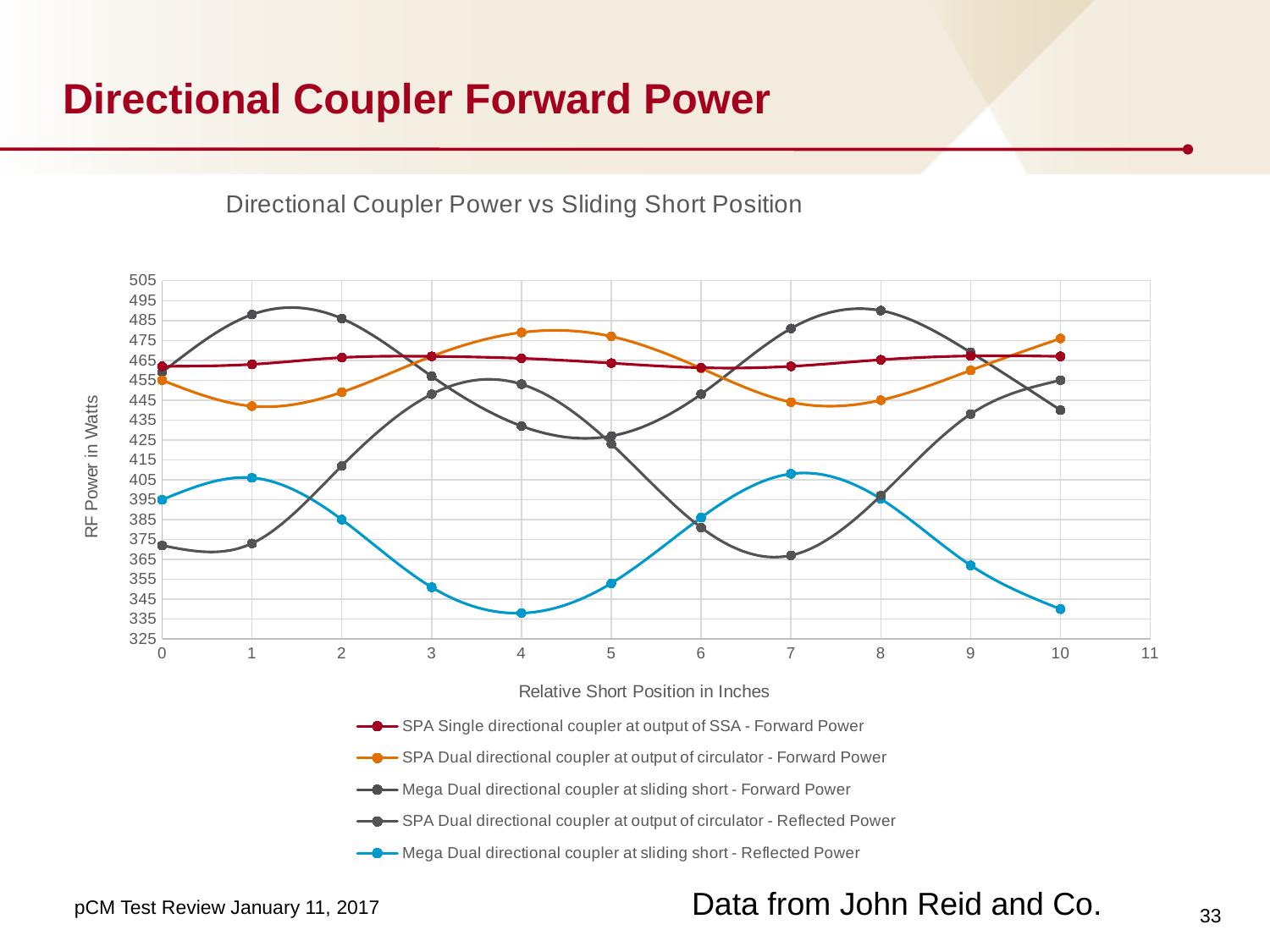
What is the title of the chart? Directional Coupler Power vs Sliding Short Position At position 4, which is higher: the SPA Dual directional coupler at output of circulator - Forward Power series or the SPA Single directional coupler at output of SSA - Forward Power series? SPA Dual directional coupler at output of circulator - Forward Power What kind of chart is shown on the slide? line chart Is the value of the SPA Single directional coupler at output of SSA - Forward Power series at position 2 greater or less than 455? greater What is the label of the vertical axis? RF Power in Watts Is the value of the SPA Dual directional coupler at output of circulator - Forward Power series at position 1 greater or less than 455? less Is the value of the SPA Dual directional coupler at output of circulator - Forward Power series at position 4 greater or less than 465? greater At position 10, which is higher: the SPA Dual directional coupler at output of circulator - Forward Power series or the Mega Dual directional coupler at sliding short - Reflected Power series? SPA Dual directional coupler at output of circulator - Forward Power How many series does the legend list? 5 Does the Mega Dual directional coupler at sliding short - Reflected Power series rise or fall from position 7 to position 10? fall How many data points are plotted for each series (short positions 0 through 10)? 11